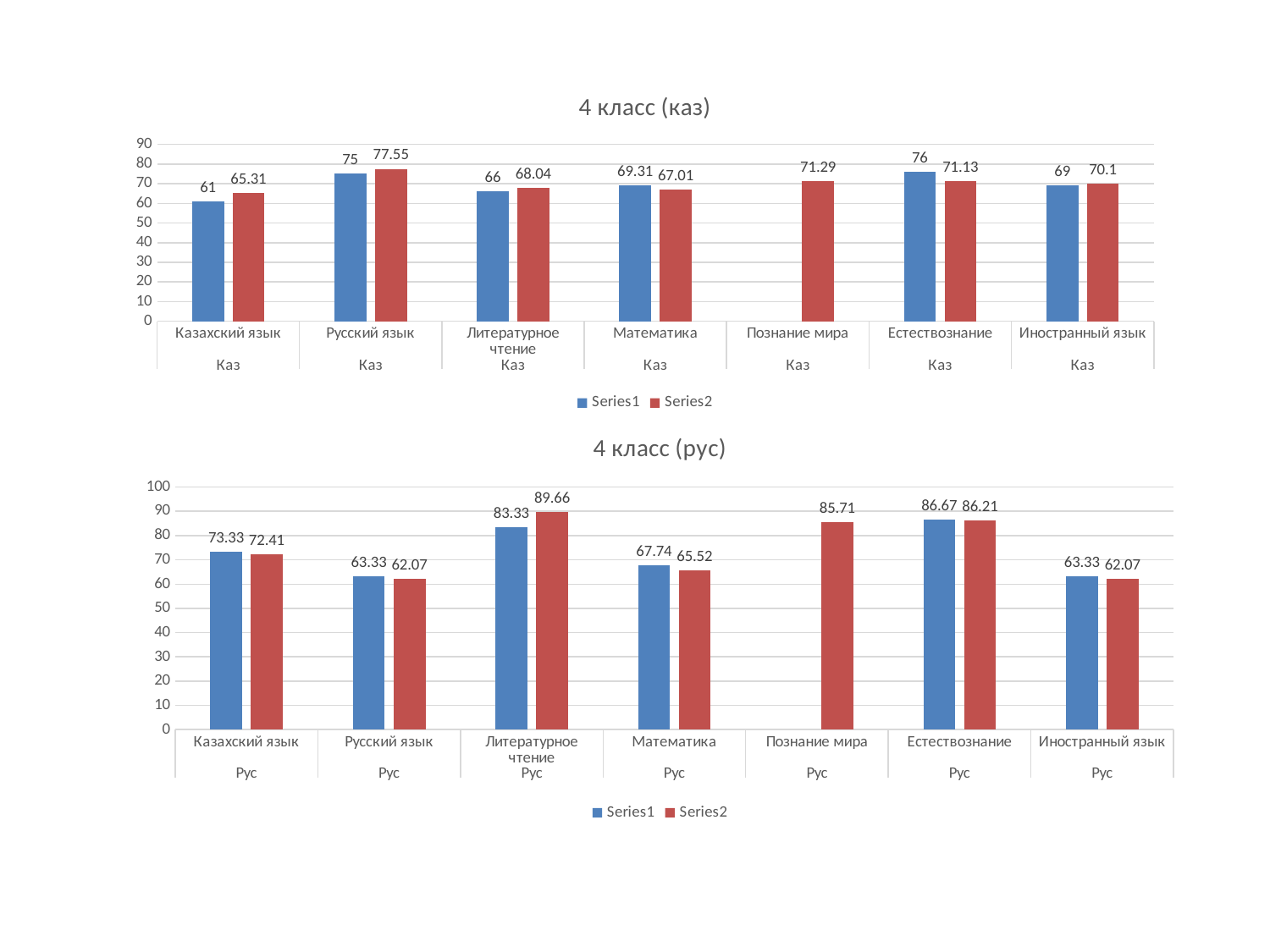
In the chart titled "4 класс (рус)", what is the Series2 value for Познание мира? 85.71 In the chart titled "4 класс (рус)", which category has the highest Series1 value? Естествознание How many series does the legend of the chart titled "4 класс (каз)" list? 2 In the chart titled "4 класс (каз)", what is the Series2 value for Русский язык? 77.55 In the chart titled "4 класс (каз)", which category has the lowest Series1 value? Казахский язык In the chart titled "4 класс (рус)", is the Series1 value for Казахский язык greater or less than 70? greater In the chart titled "4 класс (рус)", what is the Series2 value for Литературное чтение? 89.66 In the chart titled "4 класс (каз)", what is the Series1 value for Естествознание? 76 In the chart titled "4 класс (каз)", which is larger for Математика, Series1 or Series2? Series1 In the chart titled "4 класс (каз)", what is the difference between the Series2 and Series1 values for Казахский язык? 4.31 In the chart titled "4 класс (рус)", what is the difference between the Series1 and Series2 values for Математика? 2.22 What kind of chart is the chart titled "4 класс (рус)"? Bar chart